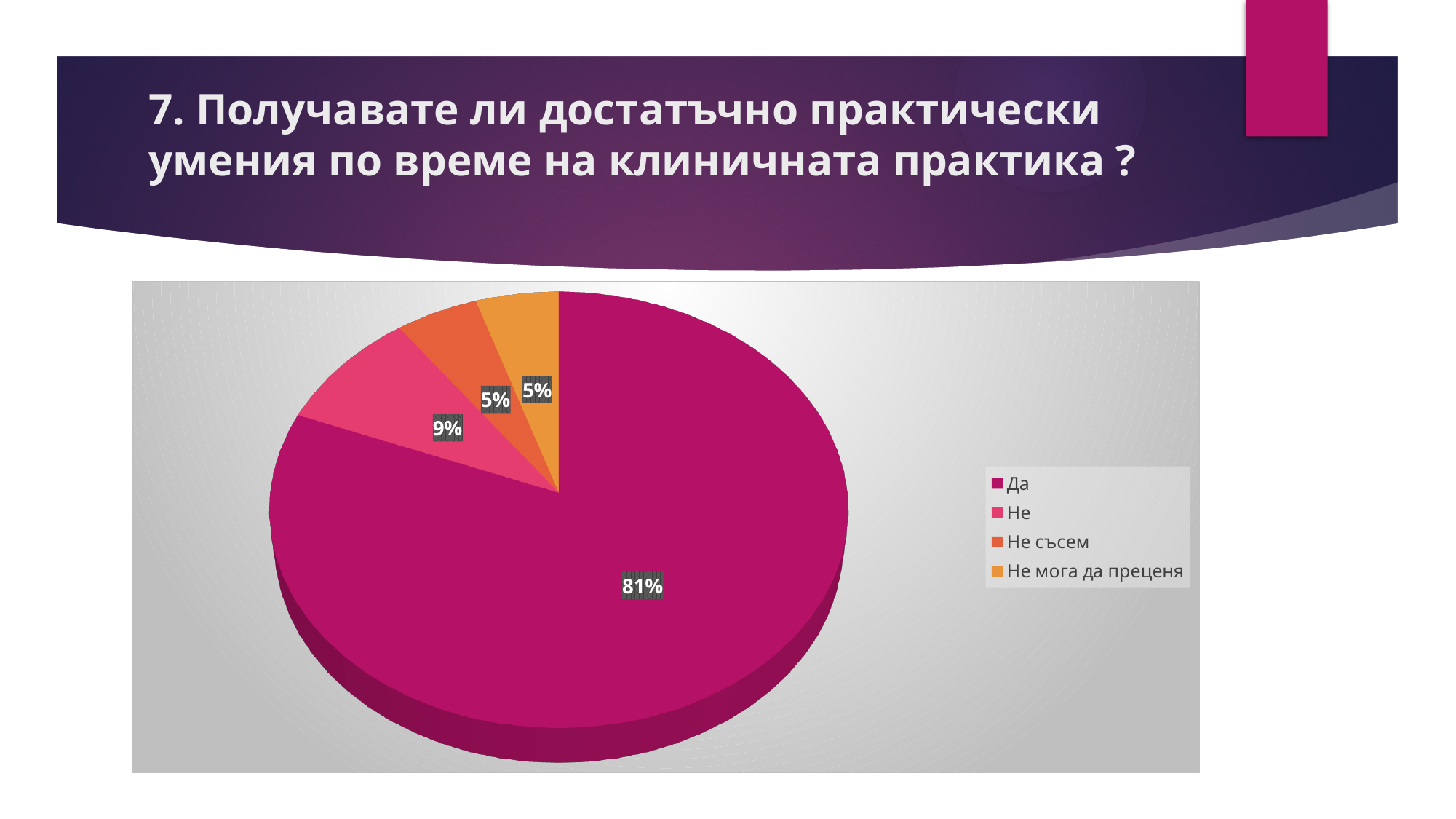
What is the value shown for the "Не" slice? 9% Is the value for "Да" greater or less than 50%? greater What is the difference in percentage points between the "Да" slice and the "Не" slice? 72 What type of chart is shown on the slide? pie chart How many categories does the legend list? 4 What is the value shown for the "Не мога да преценя" slice? 5% Which is larger, the "Не" slice or the "Не съсем" slice? Не What is the value shown for the "Не съсем" slice? 5% What is the title of the slide above the chart? 7. Получавате ли достатъчно практически умения по време на клиничната практика ? What colour is the "Не мога да преценя" slice? orange Which category has the largest slice of the pie? Да What share of the pie does the "Да" slice represent? 81%